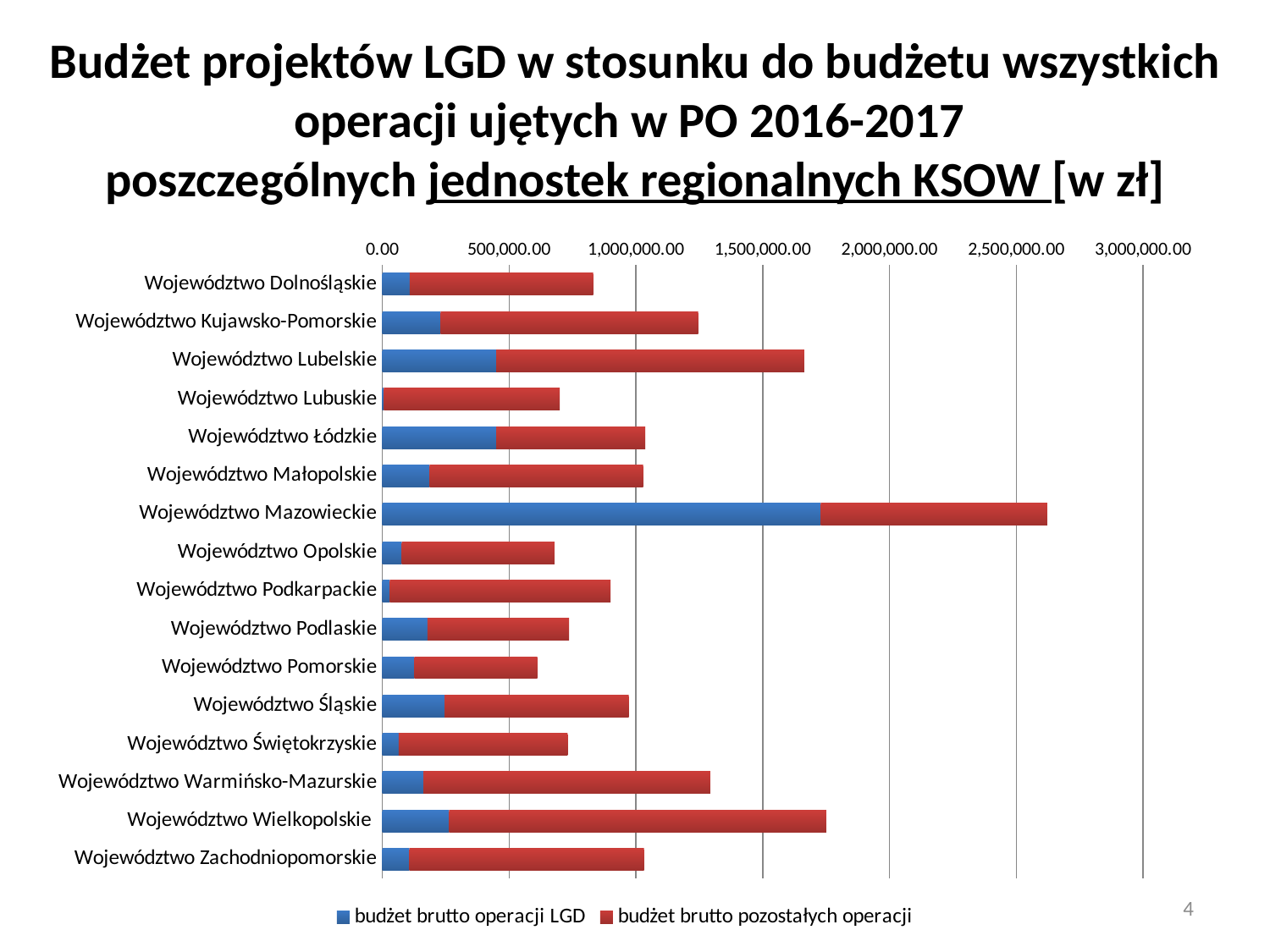
Is the total bar for Województwo Dolnośląskie greater or less than 1,000,000.00? less Which voivodeship has the highest total budget bar? Województwo Mazowieckie Which voivodeship has the largest 'budżet brutto operacji LGD' segment? Województwo Mazowieckie What kind of chart is shown on the slide? Stacked bar chart Is the total bar for Województwo Lubelskie greater or less than 1,500,000.00? greater How many voivodeships (categories) are plotted on the chart? 16 Which has the larger total bar, Województwo Śląskie or Województwo Podlaskie? Województwo Śląskie Is the 'budżet brutto operacji LGD' segment for Województwo Mazowieckie greater or less than 1,500,000.00? greater How many series does the legend list? 2 What colour represents the series 'budżet brutto operacji LGD'? Blue Which has the larger total bar, Województwo Lubelskie or Województwo Łódzkie? Województwo Lubelskie